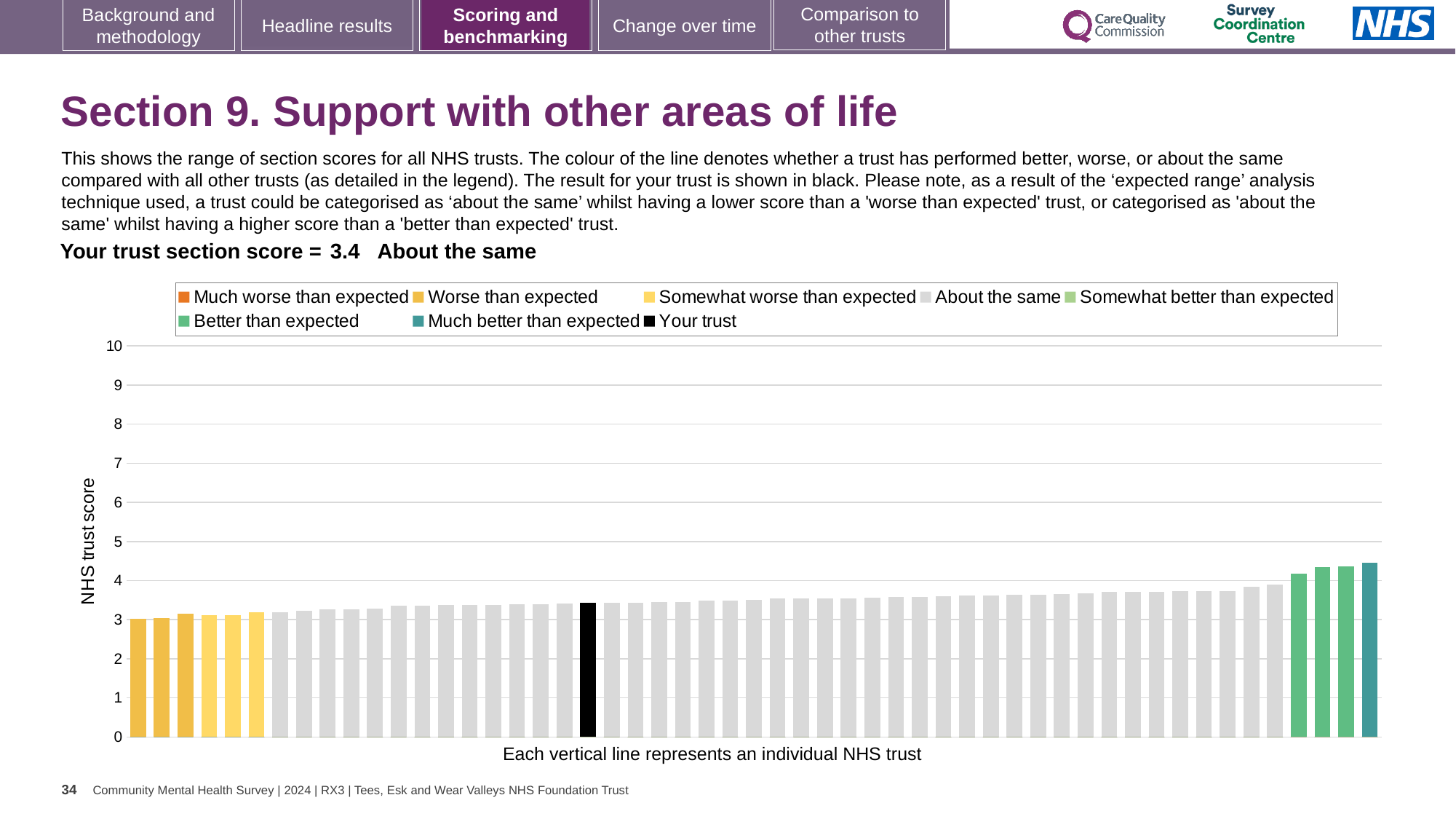
Is the value of the black 'Your trust' bar greater or less than 4? less Is the value of the tallest bar on the chart greater or less than 4? greater Is the value of the shortest bar on the chart greater or less than 4? less What is the title of the vertical axis? NHS trust score What is the section score for your trust, as stated on the slide? 3.4 How many bars are coloured gold/yellow at the left of the chart? 6 How is your trust's section score categorised on the slide? About the same How many bars are coloured teal (Much better than expected)? 1 Do the bar values rise or fall from left to right along the x axis? rise What kind of chart is shown on the slide? bar chart How many entries does the chart legend list? 8 Which is larger: the value of the black 'Your trust' bar or the value of the rightmost bar? the rightmost bar